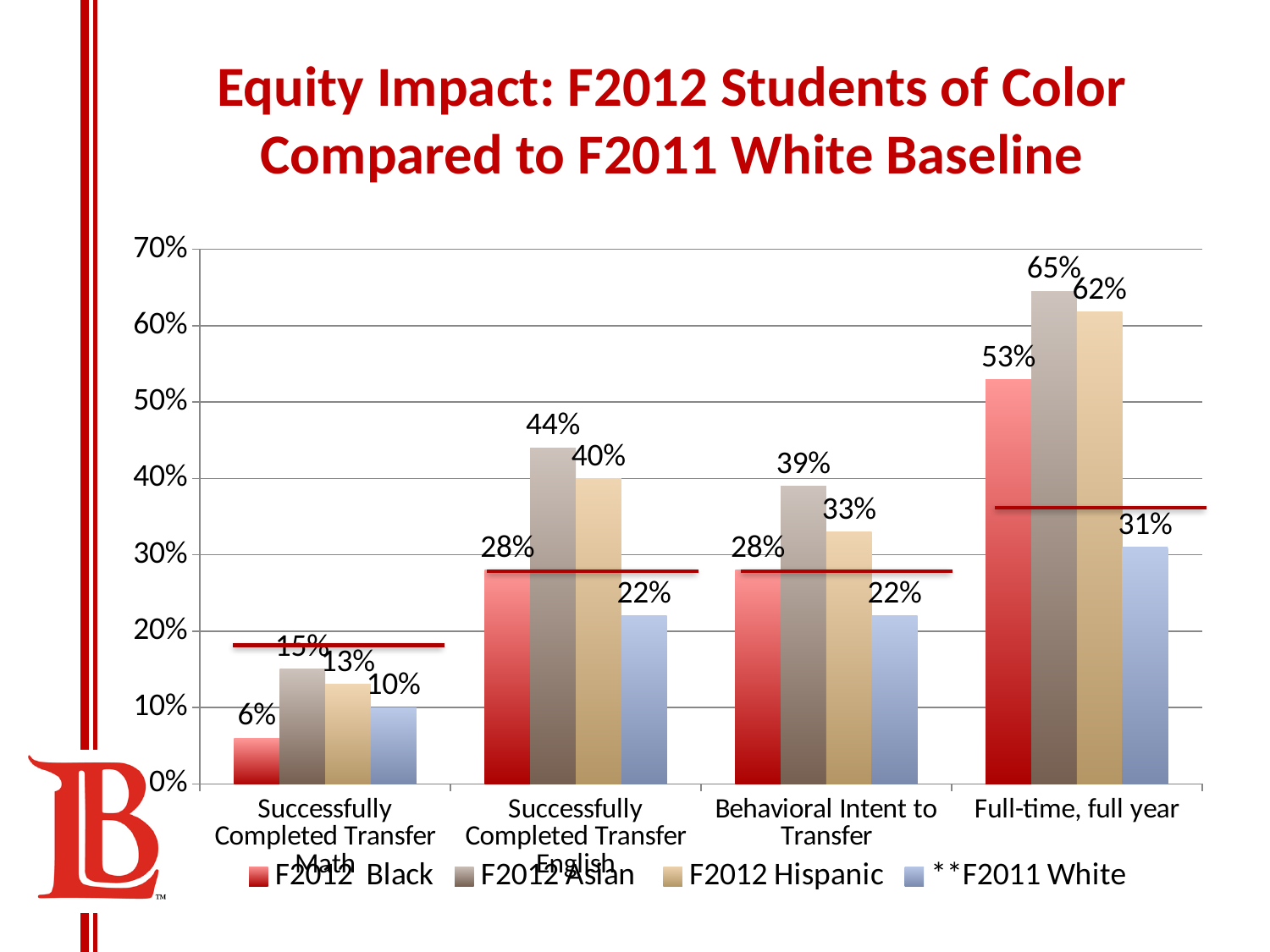
How many series does the legend list? 4 Which series has the highest value in the Full-time, full year category? F2012 Asian How many categories are shown on the x axis? 4 Which series has the lowest value in the Successfully Completed Transfer Math category? F2012 Black What kind of chart is shown on the slide? Bar chart What is the title of the slide? Equity Impact: F2012 Students of Color Compared to F2011 White Baseline What is the value for F2012 Asian in the Full-time, full year category? 65% What is the value for F2012 Black in the Successfully Completed Transfer Math category? 6% In the Behavioral Intent to Transfer category, which is larger: the F2012 Hispanic value or the F2012 Black value? F2012 Hispanic What is the difference between the F2012 Asian and F2011 White values in the Full-time, full year category? 34% What is the value for F2012 Hispanic in the Successfully Completed Transfer English category? 40% What is the value for F2011 White in the Behavioral Intent to Transfer category? 22%